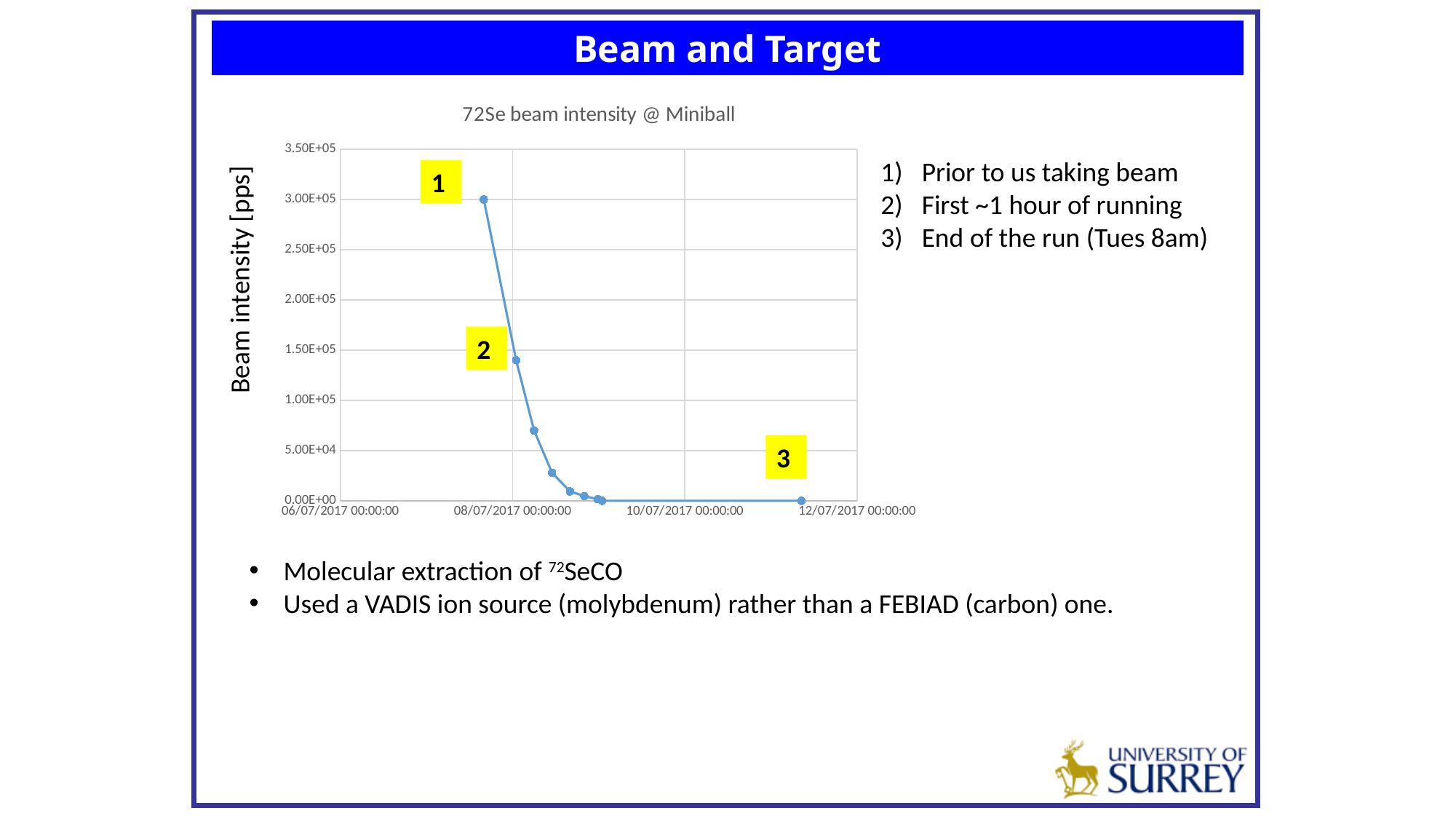
What is the last date label shown on the horizontal axis of the chart? 12/07/2017 00:00:00 Does the beam intensity rise or fall over time along the x axis? fall Is the beam intensity at the point labelled 1 greater or less than 2.50E+05? greater Is the beam intensity at the point labelled 2 greater or less than 2.00E+05? less What is the title of the chart? 72Se beam intensity @ Miniball What kind of chart is shown on the slide? line chart Which has the higher beam intensity, the point labelled 1 or the point labelled 2? 1 Is the beam intensity at the point labelled 3 greater or less than 5.00E+04? less What is the label of the vertical axis of the chart? Beam intensity [pps] Which labelled point on the chart has the lowest beam intensity? 3 Which labelled point on the chart has the highest beam intensity? 1 What is the highest value shown on the vertical axis of the chart? 3.50E+05